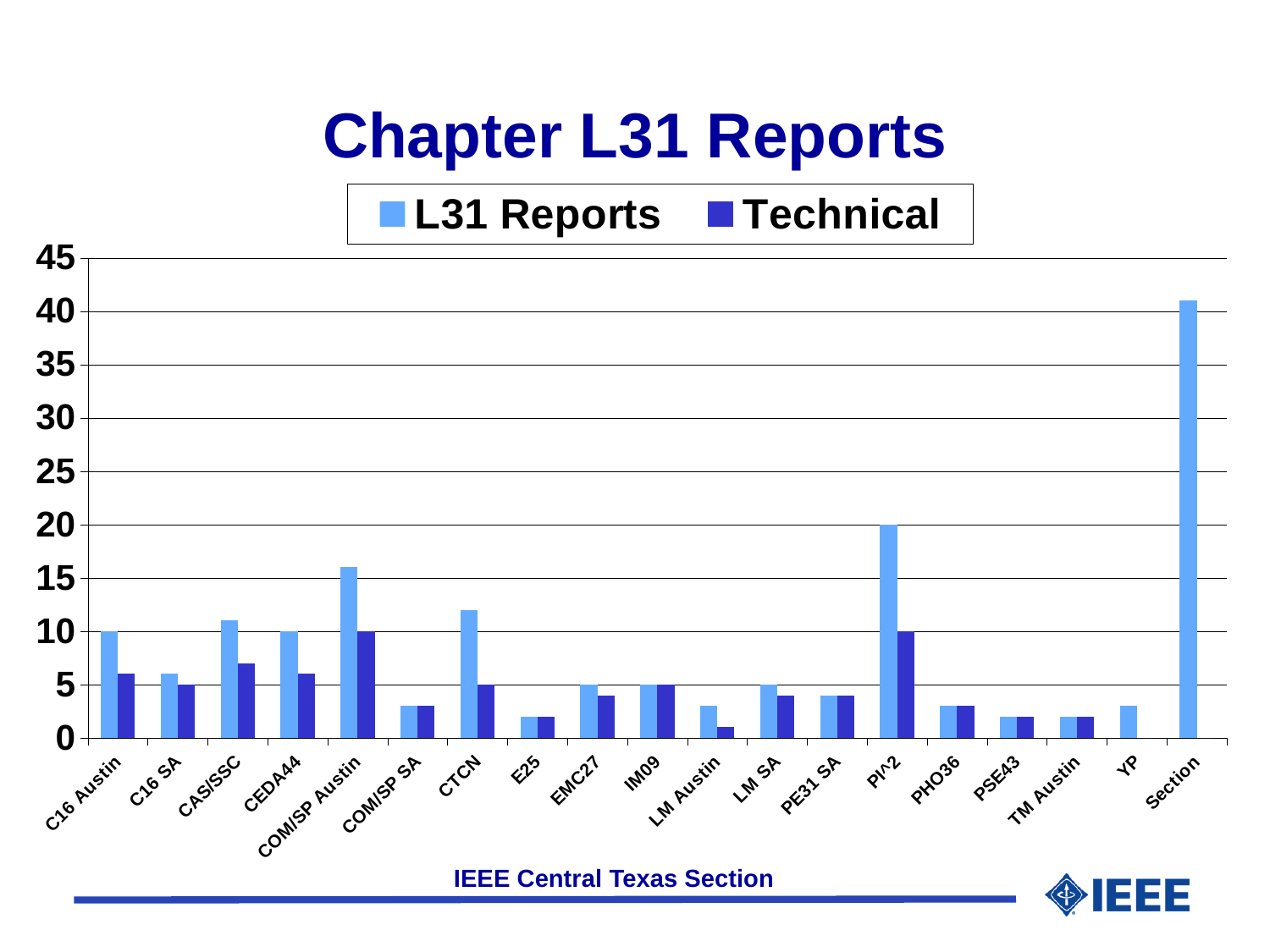
What is the L31 Reports value for C16 Austin? 10 What is the Technical value for COM/SP Austin? 10 How many series does the legend list? 2 Is the L31 Reports value for COM/SP Austin greater or less than 15? greater What is the title of the chart? Chapter L31 Reports Which is larger for CTCN, the L31 Reports value or the Technical value? L31 Reports How many categories are shown along the x axis? 19 What kind of chart is shown on the slide? bar chart Is the L31 Reports value for Section greater or less than 40? greater Is the Technical value for LM Austin greater or less than 5? less What is the L31 Reports value for PI^2? 20 Which category has the highest L31 Reports value? Section